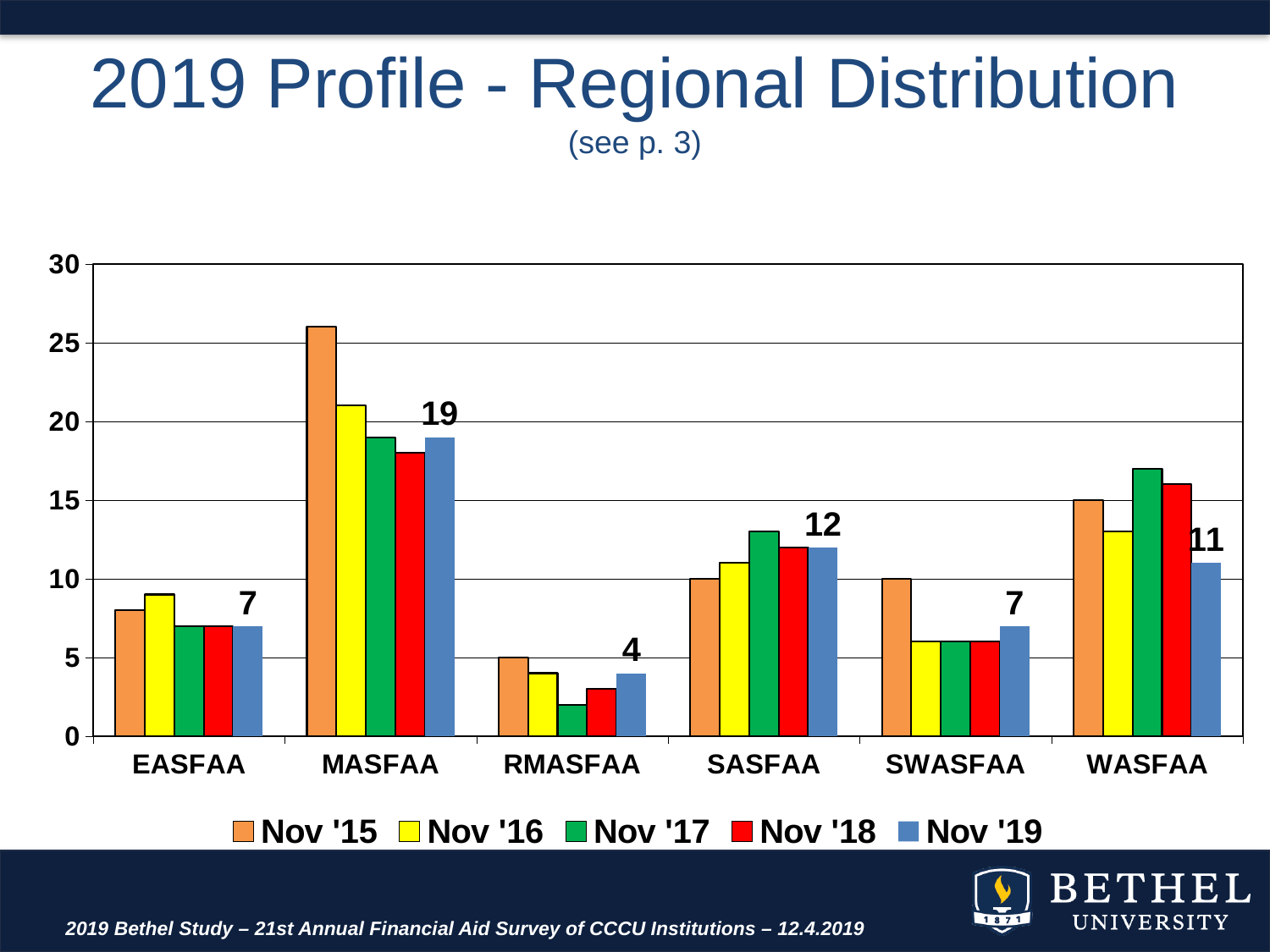
Which region has the highest Nov '19 value? MASFAA What kind of chart is shown on the slide? bar chart Is the Nov '15 value for MASFAA greater or less than 25? greater What is the Nov '19 value for MASFAA? 19 How many regions are shown on the x axis? 6 Which has the larger Nov '19 value, WASFAA or SASFAA? SASFAA How many series does the legend list? 5 What is the Nov '19 value for SASFAA? 12 Which region has the lowest Nov '19 value? RMASFAA What is the difference between the Nov '19 values for MASFAA and SASFAA? 7 Is the Nov '17 value for WASFAA greater or less than 15? greater What is the Nov '19 value for RMASFAA? 4